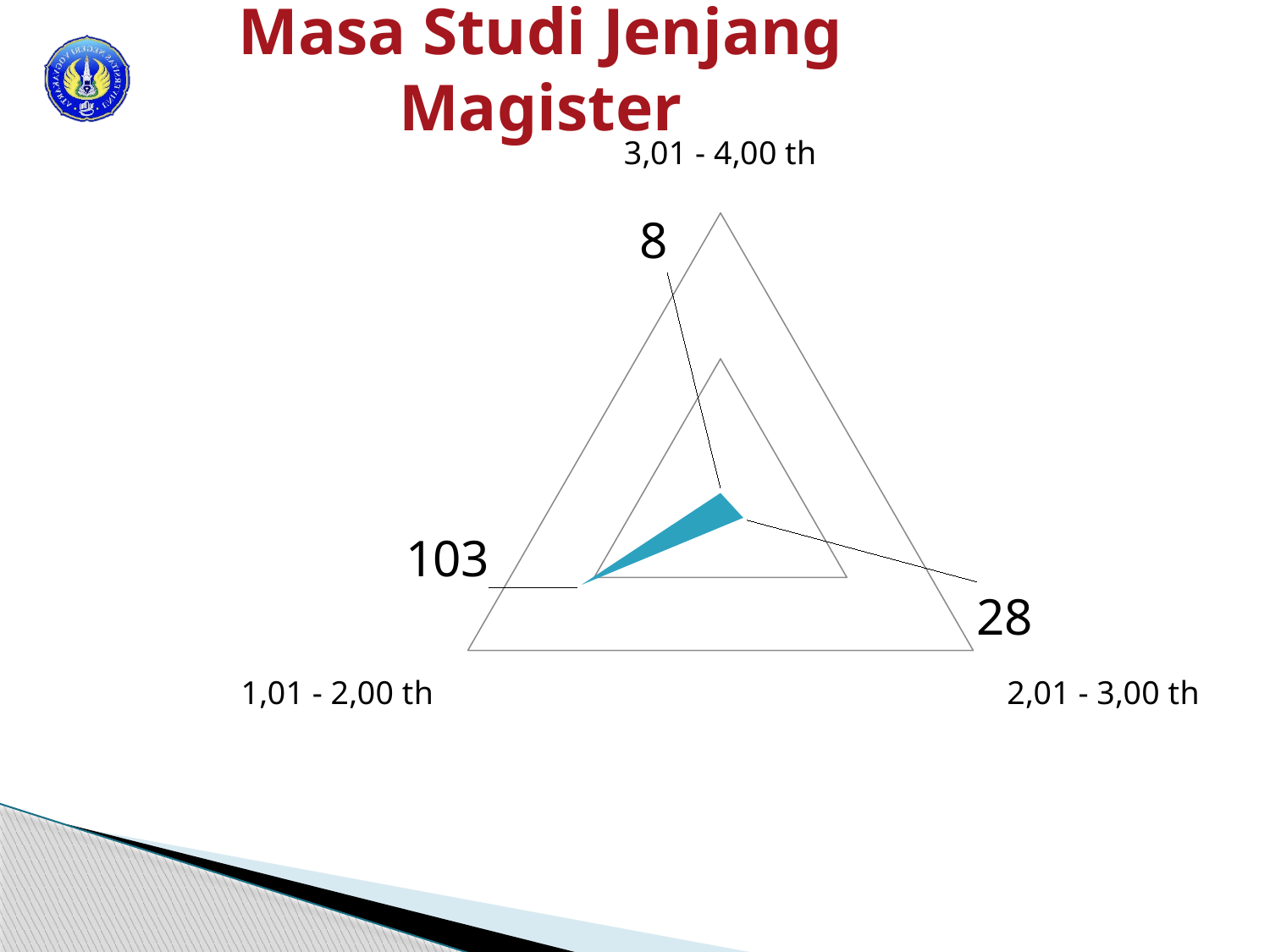
How many categories does the chart show? 3 What is the value for the category "1,01 - 2,00 th"? 103 What colour is the filled data area in the chart? Blue Which is larger, the value for "2,01 - 3,00 th" or the value for "3,01 - 4,00 th"? 2,01 - 3,00 th What is the value for the category "3,01 - 4,00 th"? 8 What is the difference between the values for "1,01 - 2,00 th" and "2,01 - 3,00 th"? 75 Which category has the lowest value? 3,01 - 4,00 th Which category has the highest value? 1,01 - 2,00 th What kind of chart is shown on the slide? Radar chart What is the title of the slide containing the chart? Masa Studi Jenjang Magister What is the difference between the values for "2,01 - 3,00 th" and "3,01 - 4,00 th"? 20 What is the value for the category "2,01 - 3,00 th"? 28